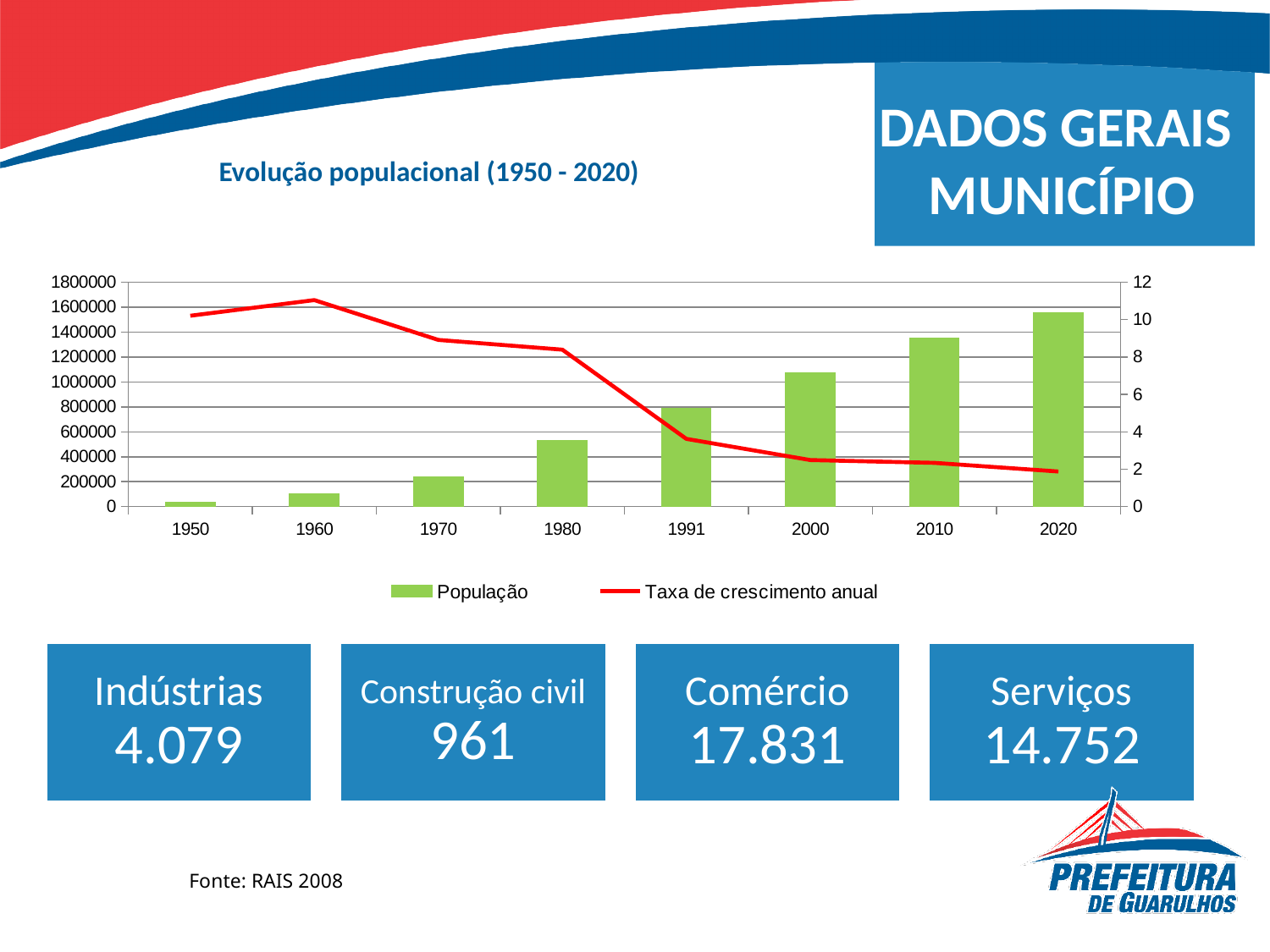
How many series does the chart legend list? 2 In which year is the Taxa de crescimento anual line at its highest? 1960 What kind of chart is shown on the slide? Combined bar and line chart What is the title of the chart? Evolução populacional (1950 - 2020) Do the População bars rise or fall from 1950 to 2020? Rise Which series is drawn as a red line in the chart? Taxa de crescimento anual Is the Taxa de crescimento anual value for 1991 greater or less than 4? less Is the População value for 2020 greater or less than 1400000? greater How many years are shown on the x axis of the chart? 8 Which year has the lowest População bar? 1950 Which year has the highest População bar? 2020 Does the Taxa de crescimento anual line rise or fall from 1960 to 2020? Fall